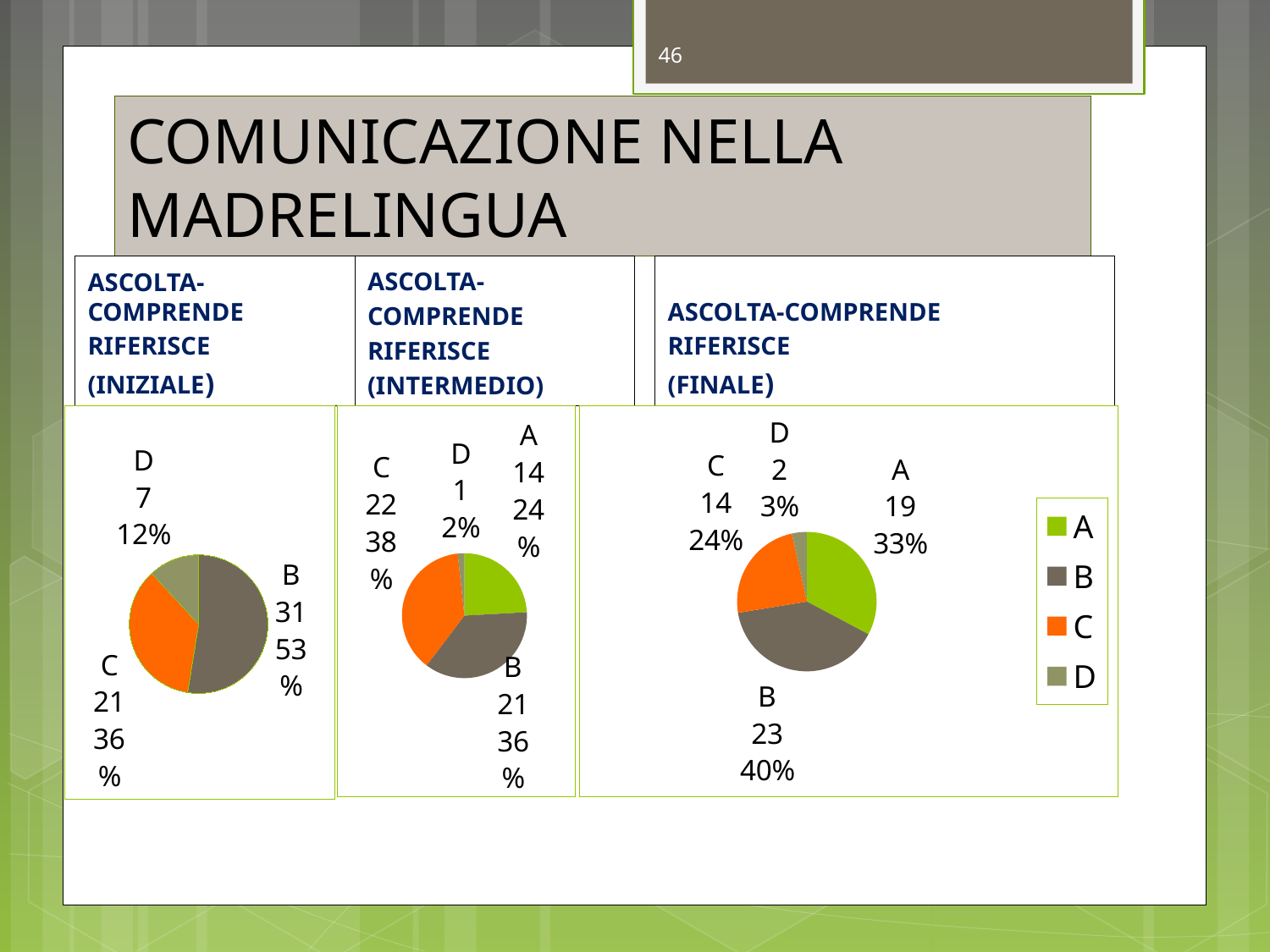
In the INIZIALE pie chart, what value is shown for category B? 31 In the INIZIALE pie chart, which category has the smallest slice? D In the INTERMEDIO pie chart, which category has the largest share? C In the INTERMEDIO pie chart, what value is shown for category A? 14 In the INIZIALE pie chart, what percentage share does category C have? 36% How many categories does the legend on the right of the slide list? 4 What type of chart is used for the FINALE data? Pie chart In the FINALE pie chart, which is larger, the value for A or the value for C? A In the FINALE pie chart, what is the difference between the values for B and C? 9 In the INTERMEDIO pie chart, what percentage share does category D have? 2% In the FINALE pie chart, what percentage share does category D have? 3% In the FINALE pie chart, what value is shown for category B? 23